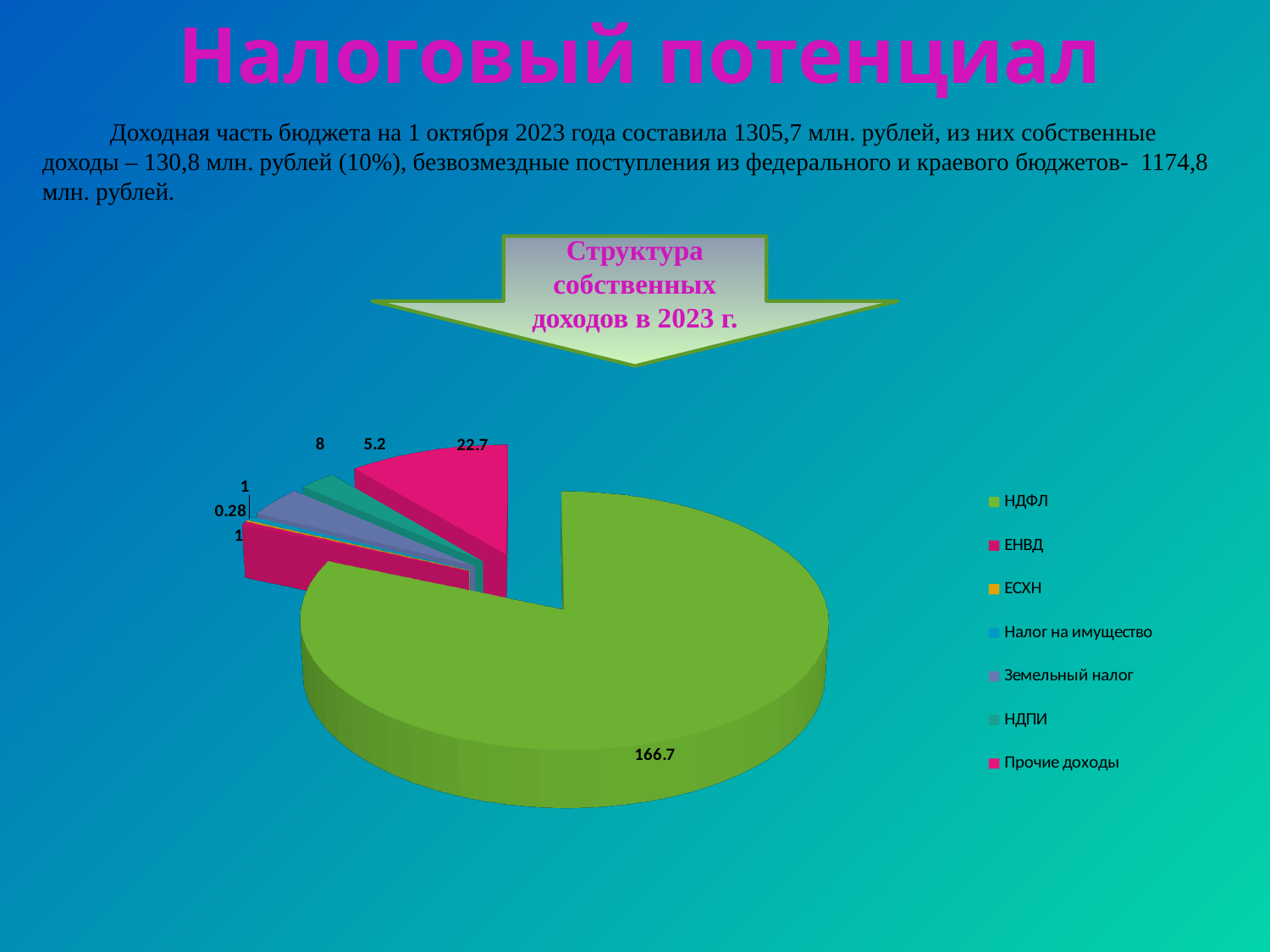
How many entries does the chart legend list? 7 What is the value for НДФЛ in the pie chart? 166.7 What is the first entry listed in the chart legend? НДФЛ Which is larger, the slice labelled 166.7 or the slice labelled 22.7? 166.7 What is the value printed on the largest slice of the pie chart? 166.7 What is the smallest value printed as a data label on the pie chart? 0.28 What kind of chart is shown on the slide? pie chart What is the difference between the slice labelled 166.7 and the slice labelled 22.7? 144 Which category has the largest slice in the pie chart? НДФЛ What is the last entry listed in the chart legend? Прочие доходы What is the difference between the slice labelled 8 and the slice labelled 5.2? 2.8